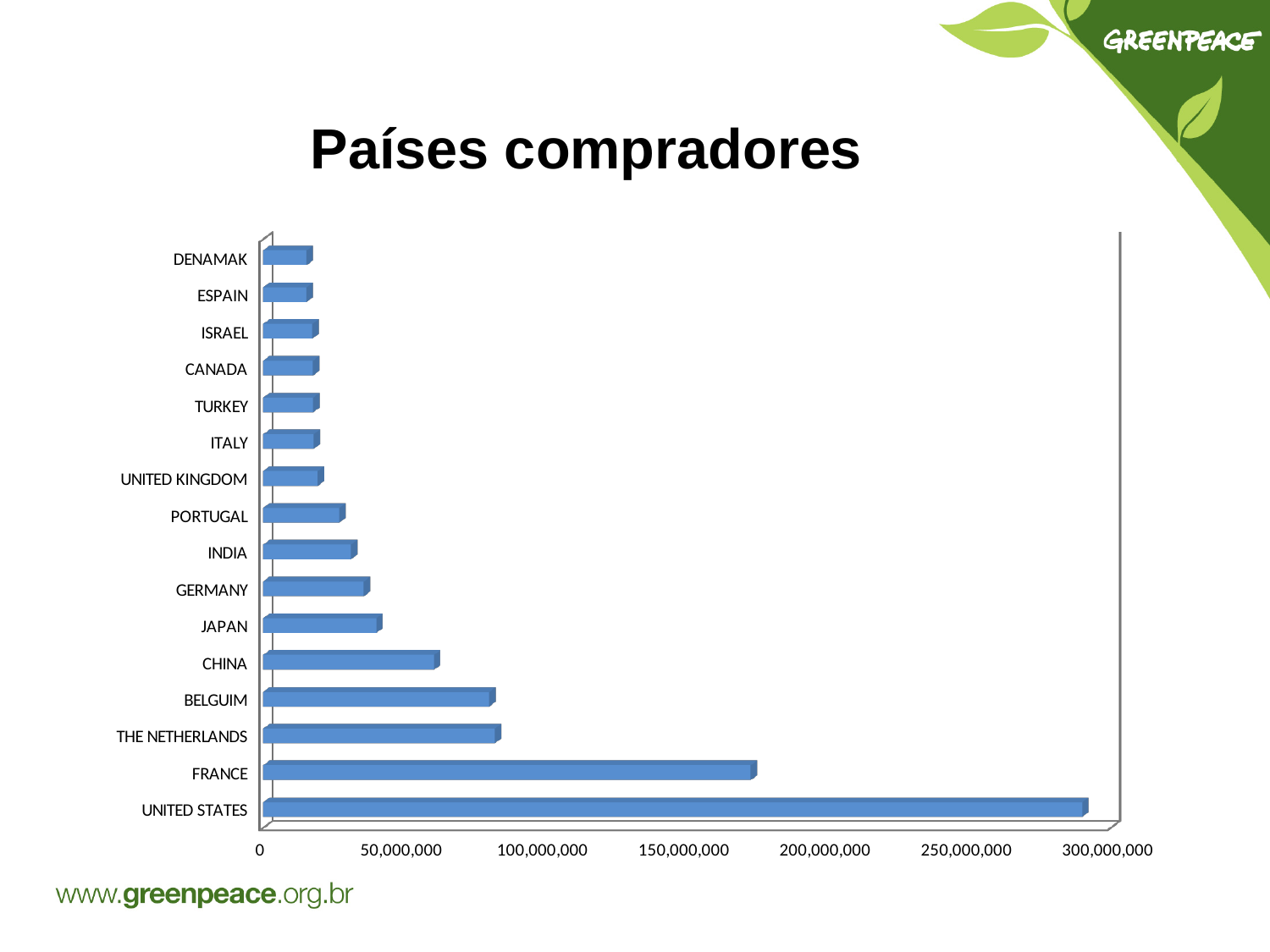
Is the value for THE NETHERLANDS greater or less than 100,000,000? less What is the title of the slide containing the chart? Países compradores Which country has the highest value in the chart? UNITED STATES Is the value for CHINA greater or less than 50,000,000? greater Is the value for FRANCE greater or less than 150,000,000? greater How many countries are shown in the chart? 16 What kind of chart is shown on the slide? bar chart Which has a larger value, BELGUIM or GERMANY? BELGUIM Which has a larger value, CHINA or JAPAN? CHINA